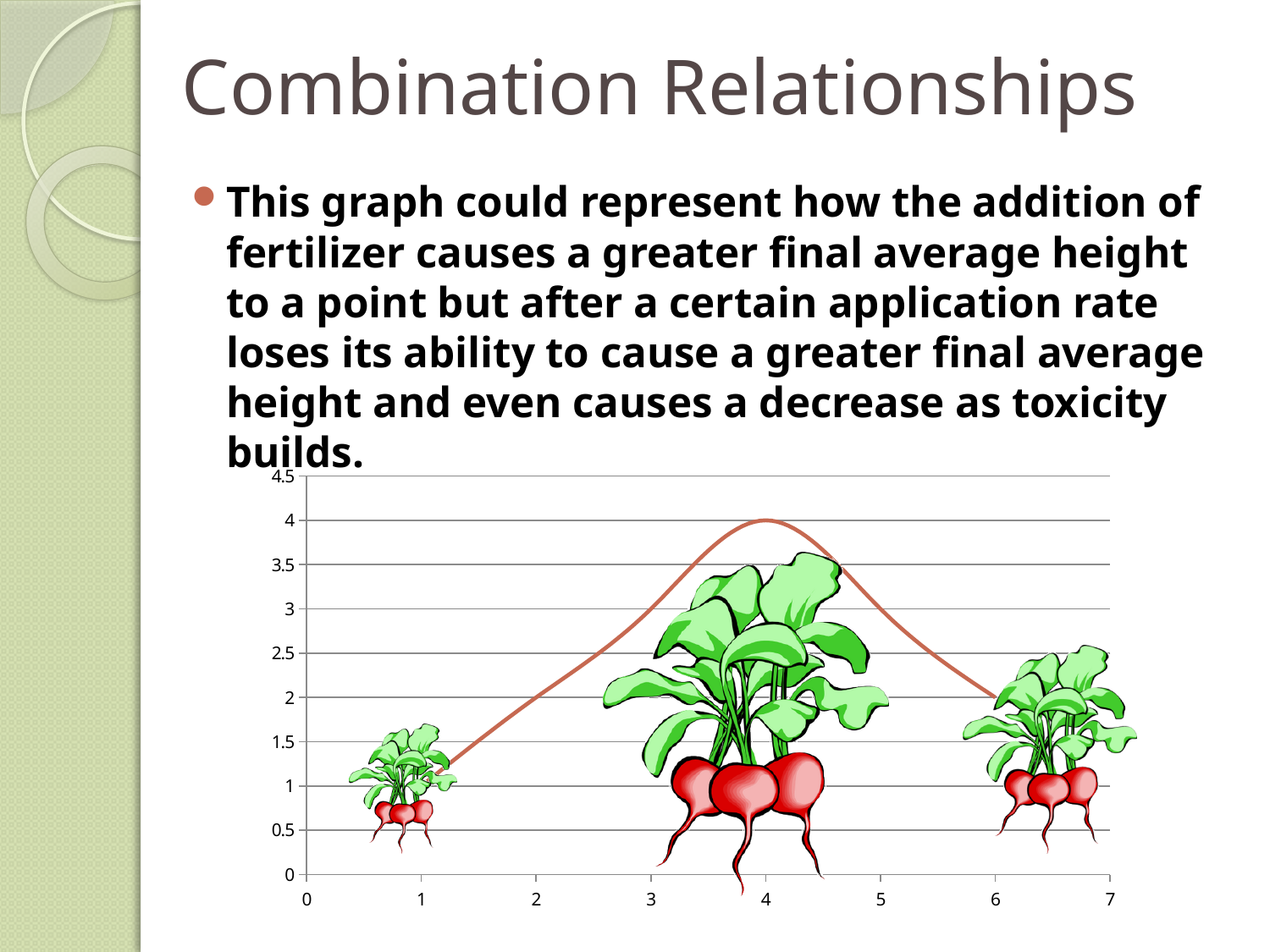
What kind of chart is shown on the slide? line chart Does the curve rise or fall between x = 4 and x = 6? falls Is the value of the curve at x = 2 greater or less than 2.5? less What is the value of the curve at x = 6, where it ends? 2 What is the highest value shown on the x axis? 7 Is the value of the curve at x = 5 greater or less than 3.5? less What is the peak value of the curve, read from the y axis? 4 At which x-axis value does the curve reach its highest point? 4 Which is larger: the value of the curve at x = 4 or at x = 6? x = 4 Does the curve rise or fall between x = 2 and x = 4? rises Is the value of the curve at x = 3 greater or less than 2? greater What is the highest value shown on the y axis? 4.5